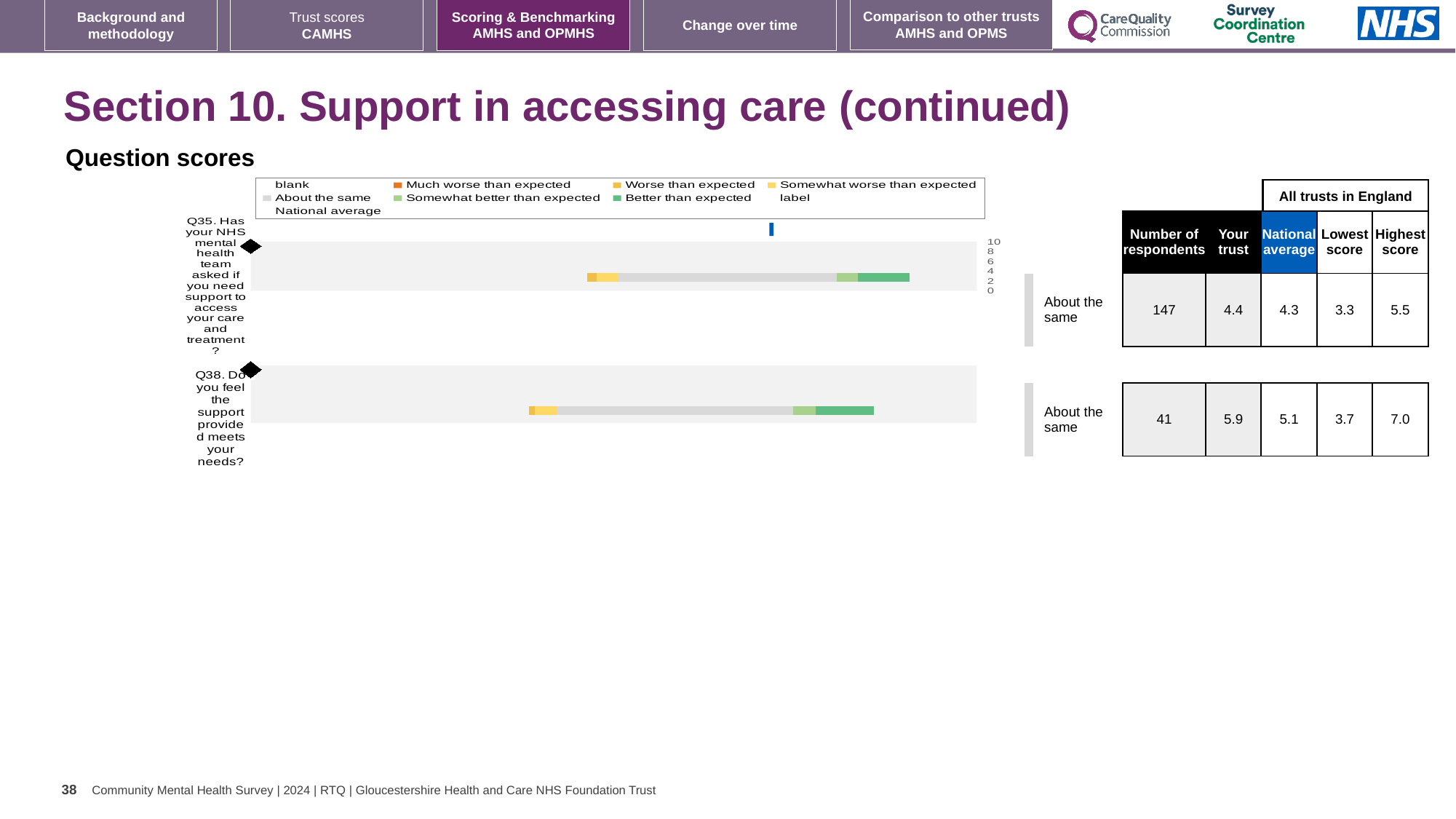
What benchmark category is shown next to the chart for Q35? About the same In the table beside the chart, what is the number of respondents for Q35? 147 What is the difference between the highest score and the lowest score for Q38? 3.3 How many questions (categories) are plotted in the chart? 2 What is the difference between the 'Your trust' score and the national average for Q35? 0.1 In the table beside the chart, what is the national average for Q35? 4.3 Which question has the higher 'Your trust' score, Q35 or Q38? Q38 In the chart legend, what colour represents 'Better than expected'? green In the table beside the chart, what is the highest score for Q38? 7.0 What kind of chart is shown under 'Question scores'? bar chart In the table beside the chart, what is the 'Your trust' score for Q38? 5.9 In the chart legend, what colour represents 'Much worse than expected'? orange